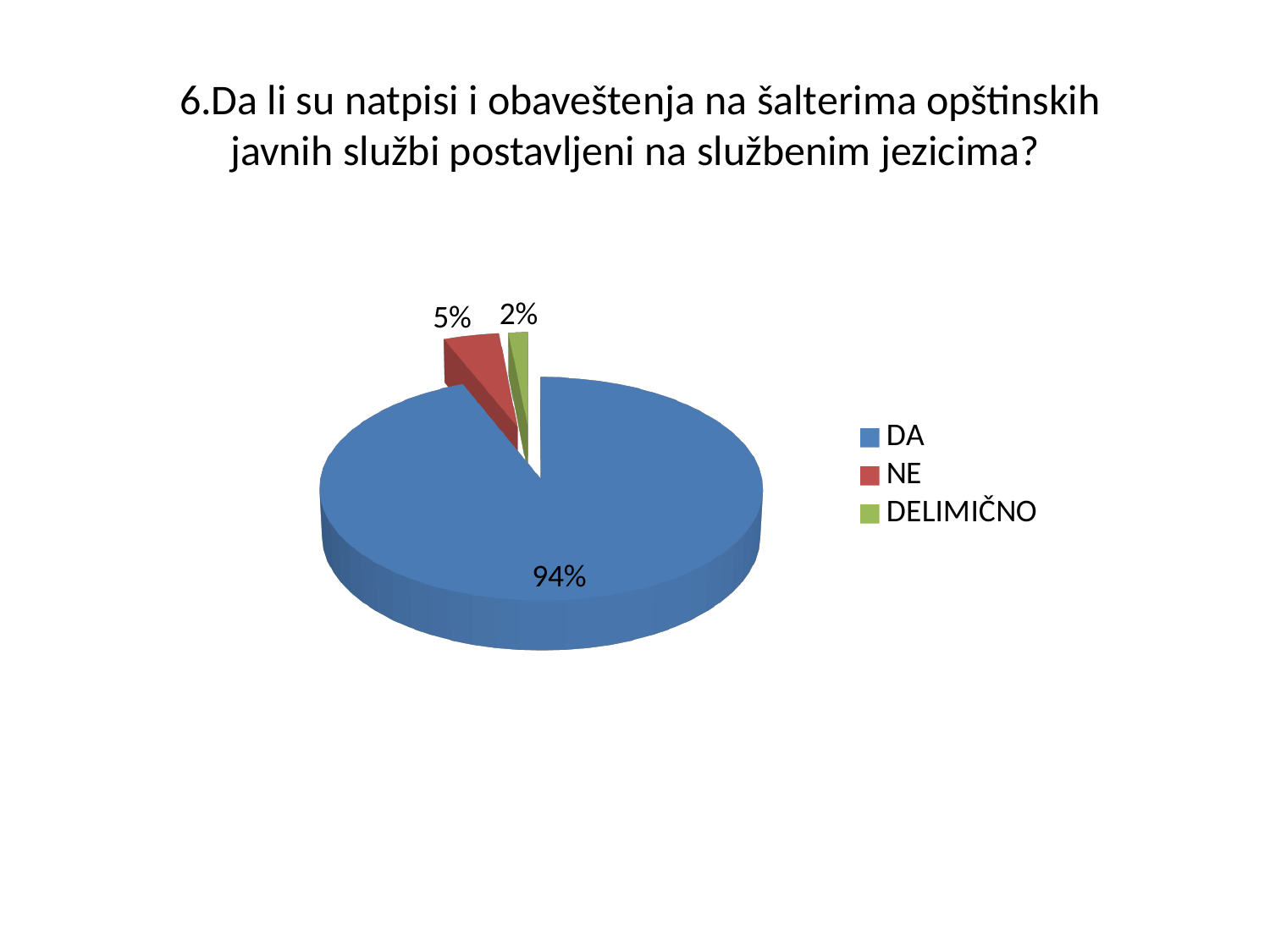
Which category has the largest slice of the pie? DA What is the difference in percentage points between the DA slice and the NE slice? 89 Which is larger, the NE slice or the DELIMIČNO slice? NE Which category has the smallest slice of the pie? DELIMIČNO What share of the pie does NE represent? 5% What share of the pie does DELIMIČNO represent? 2% How many categories does the pie chart show? 3 What colour is the DA slice in the pie chart? Blue What kind of chart is shown on the slide? Pie chart What is the difference in percentage points between the NE slice and the DELIMIČNO slice? 3 What share of the pie does DA represent? 94% Which legend entry is shown in green? DELIMIČNO